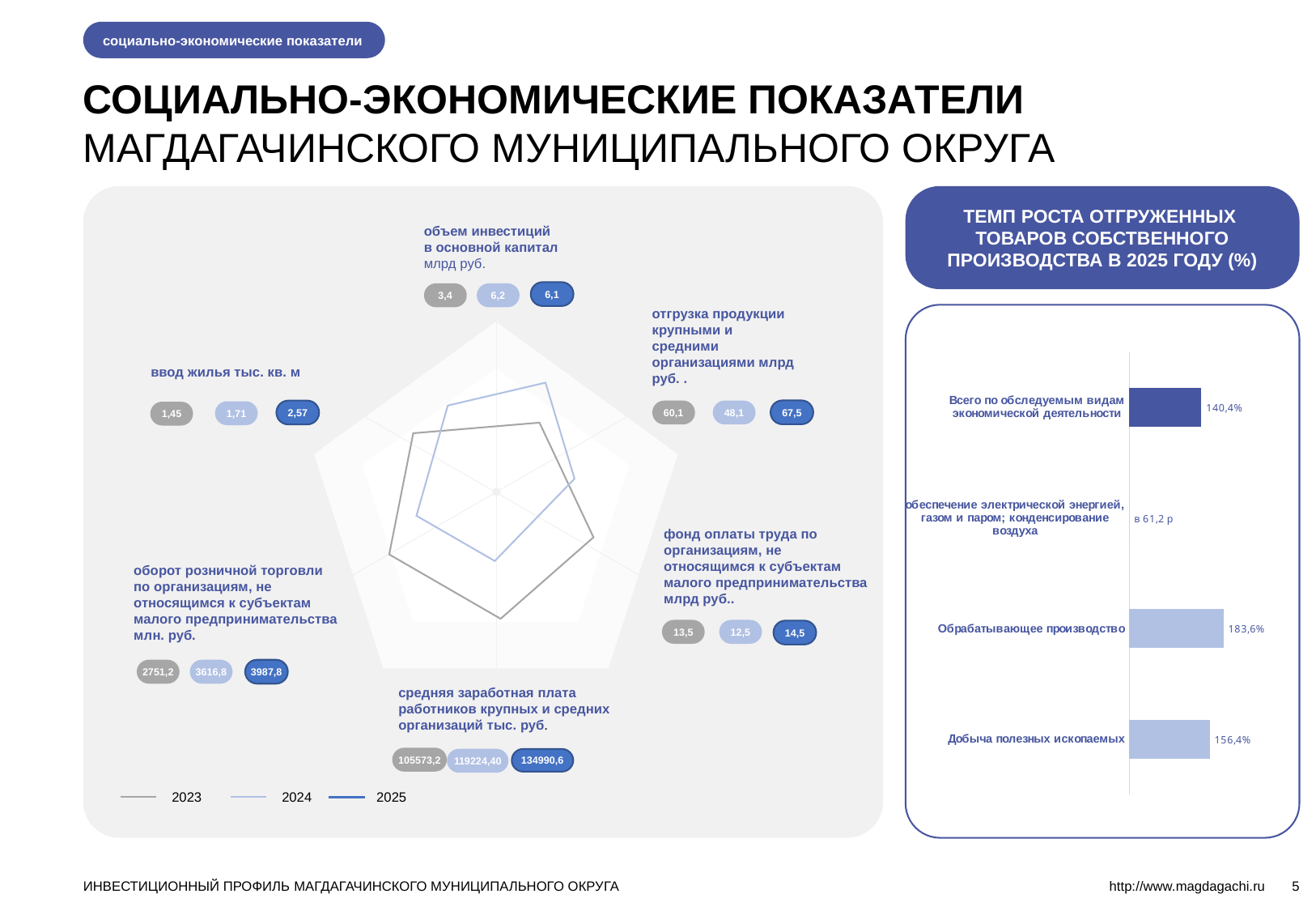
In the radar chart on the left, what is the 2023 value for ввод жилья (тыс. кв. м)? 1,45 In the radar chart on the left, what is the difference between the 2025 and 2023 values for фонд оплаты труда (млрд руб.)? 1,0 In the bar chart on the right, what is the difference between Обрабатывающее производство and Добыча полезных ископаемых? 27,2 percentage points In the bar chart on the right (ТЕМП РОСТА ОТГРУЖЕННЫХ ТОВАРОВ СОБСТВЕННОГО ПРОИЗВОДСТВА В 2025 ГОДУ), what is the value for Обрабатывающее производство? 183,6% In the radar chart on the left, what is the 2025 value for объем инвестиций в основной капитал (млрд руб.)? 6,1 In the bar chart on the right, how many categories are listed? 4 What type of chart is shown on the right side of the slide? Bar chart How many series does the legend of the radar chart on the left list? 3 In the bar chart on the right, what is the value for Всего по обследуемым видам экономической деятельности? 140,4% In the bar chart on the right, which category has the longest bar? Обрабатывающее производство In the radar chart on the left, which year has the higher value for отгрузка продукции крупными и средними организациями: 2024 or 2025? 2025 In the bar chart on the right, what is the value for Добыча полезных ископаемых? 156,4%